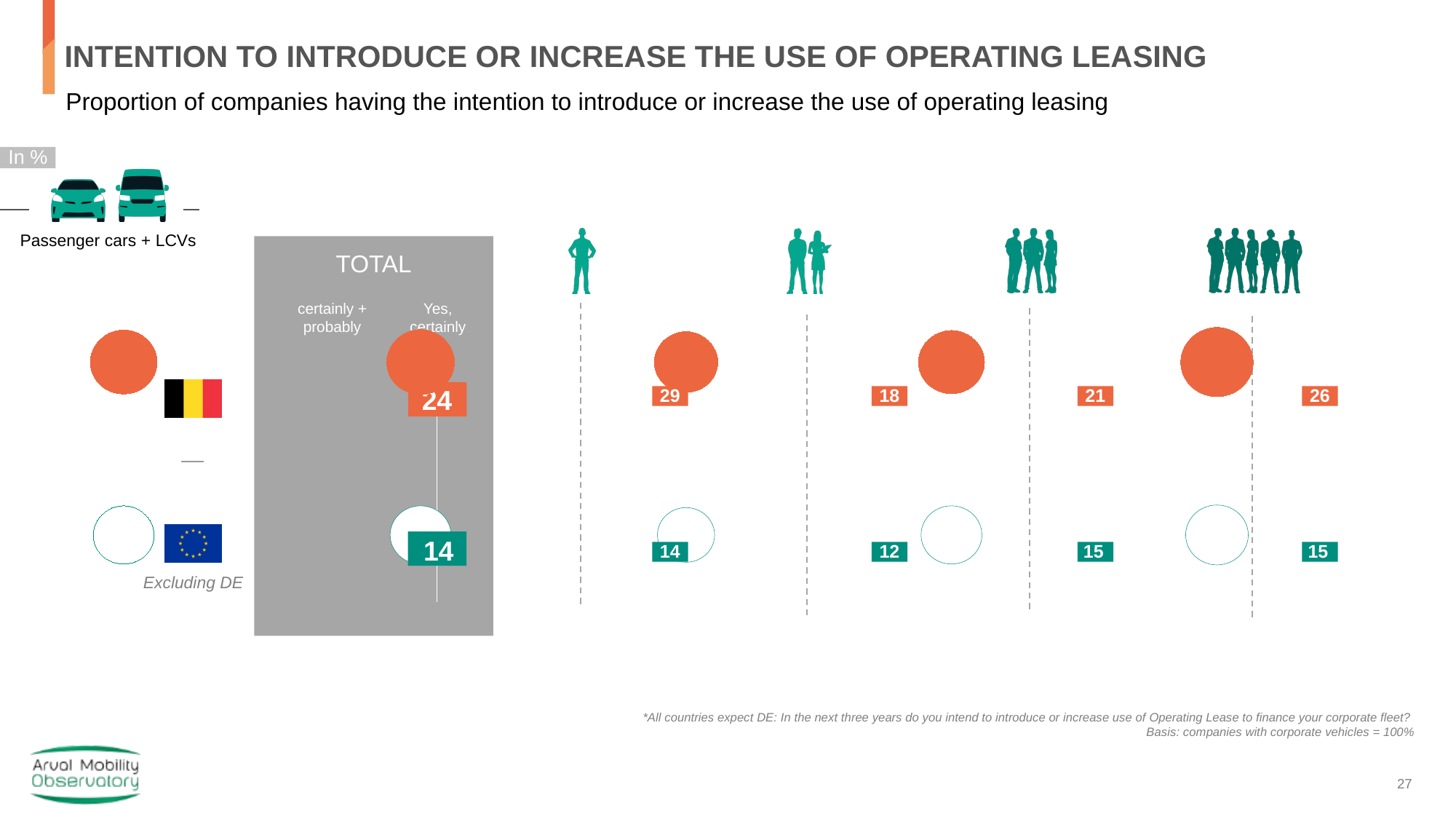
What is the Belgium value in the fourth company-size segment (largest group icon)? 26 In the third company-size segment, which is larger: the Belgium value or the Europe excluding DE value? Belgium (21 vs 15) What unit are the values on the chart expressed in? % Across the four company-size segments, which segment has the lowest Europe excluding DE value? The second segment (two-person icon), 12 How many series (countries/regions) are plotted on the chart? 2 What is the TOTAL value for Europe excluding DE (teal) for 'Yes, certainly'? 14 What is the TOTAL value for Belgium (orange) for 'Yes, certainly'? 24 What is the Belgium value in the first company-size segment to the right of the TOTAL box (single-person icon)? 29 How many company-size segments are shown to the right of the TOTAL box? 4 What is the difference between the Belgium TOTAL value (24) and the Europe excluding DE TOTAL value (14)? 10 What is the Europe excluding DE value in the second company-size segment (two-person icon)? 12 Across the four company-size segments, which segment has the highest Belgium value? The first segment (single-person icon), 29